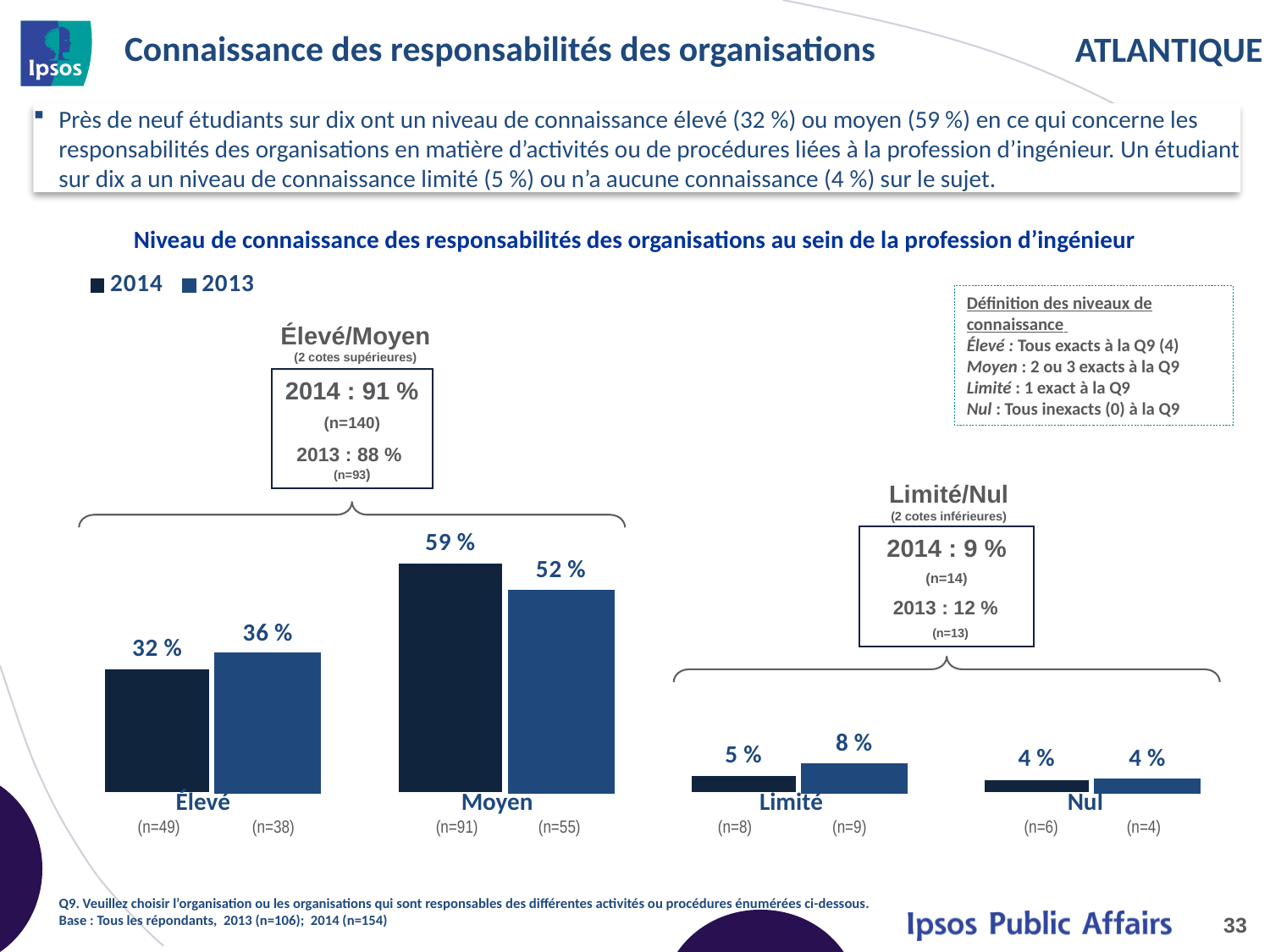
Which category has the highest 2014 value? Moyen Which series is shown in the darker navy colour? 2014 What kind of chart is shown on the slide? bar chart What is the 2013 value for Limité? 8 % How many series does the legend list? 2 What is the 2014 value for Moyen? 59 % How many categories are shown on the x axis? 4 Which is larger for Élevé, the 2014 value or the 2013 value? 2013 What is the 2013 value for Élevé? 36 % What is the combined Élevé/Moyen value for 2014 shown in the box above the chart? 91 % Which category has the lowest 2013 value? Nul What is the difference between the 2014 and 2013 values for Moyen? 7 %